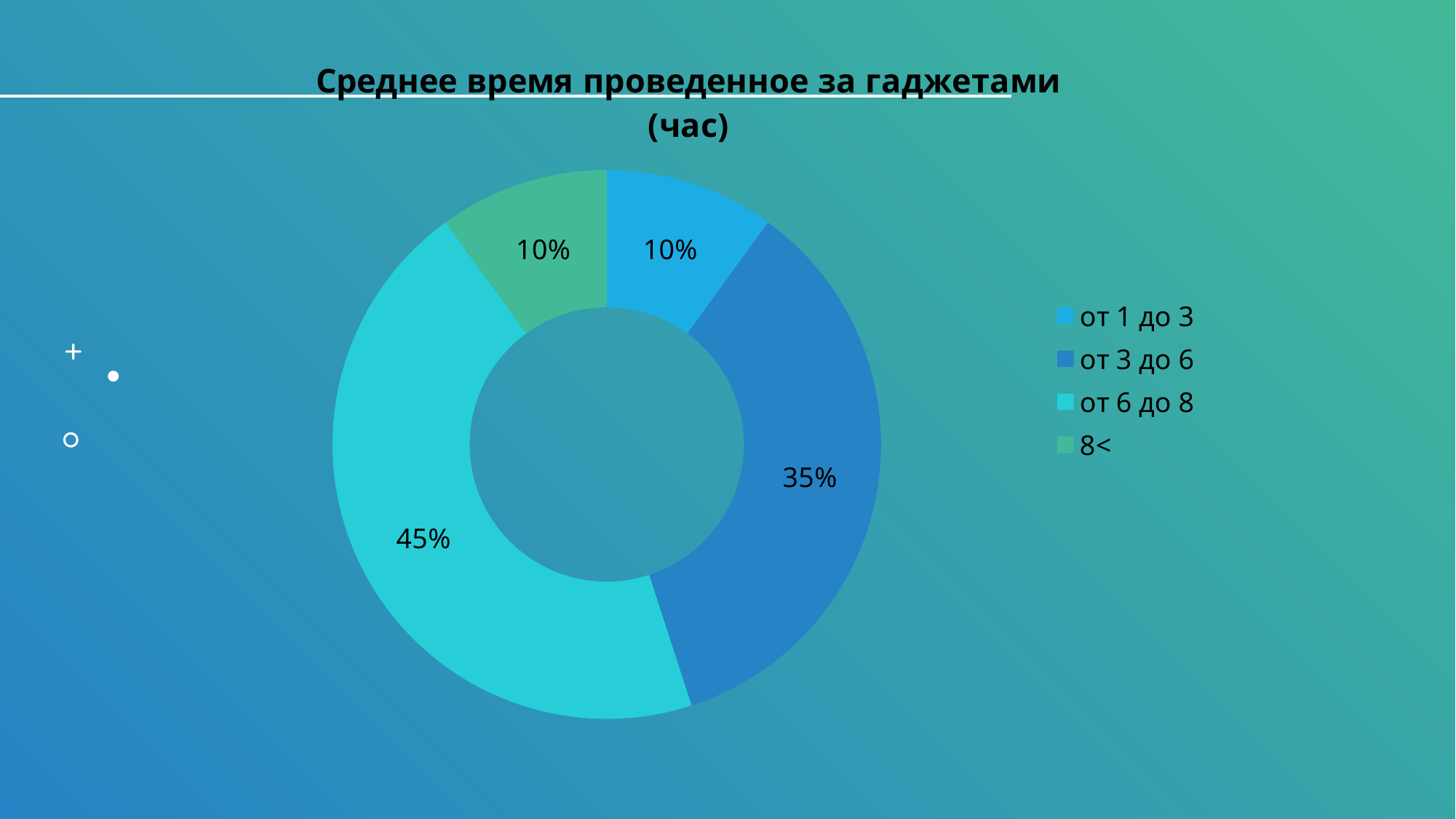
Which category has the largest share? от 6 до 8 What share of the chart does the 'от 6 до 8' category have? 45% What is the value shown for the '8<' category? 10% What is the value shown for 'от 1 до 3'? 10% What is the difference between the shares of 'от 6 до 8' and 'от 3 до 6'? 10% Which legend entry is shown in green? 8< Which is larger, the share for 'от 3 до 6' or the share for 'от 1 до 3'? от 3 до 6 What is the value shown for 'от 3 до 6'? 35% What is the title of the chart? Среднее время проведенное за гаджетами (час) What kind of chart is shown on the slide? Doughnut chart What is the difference between the shares of 'от 3 до 6' and '8<'? 25% How many categories does the chart show? 4